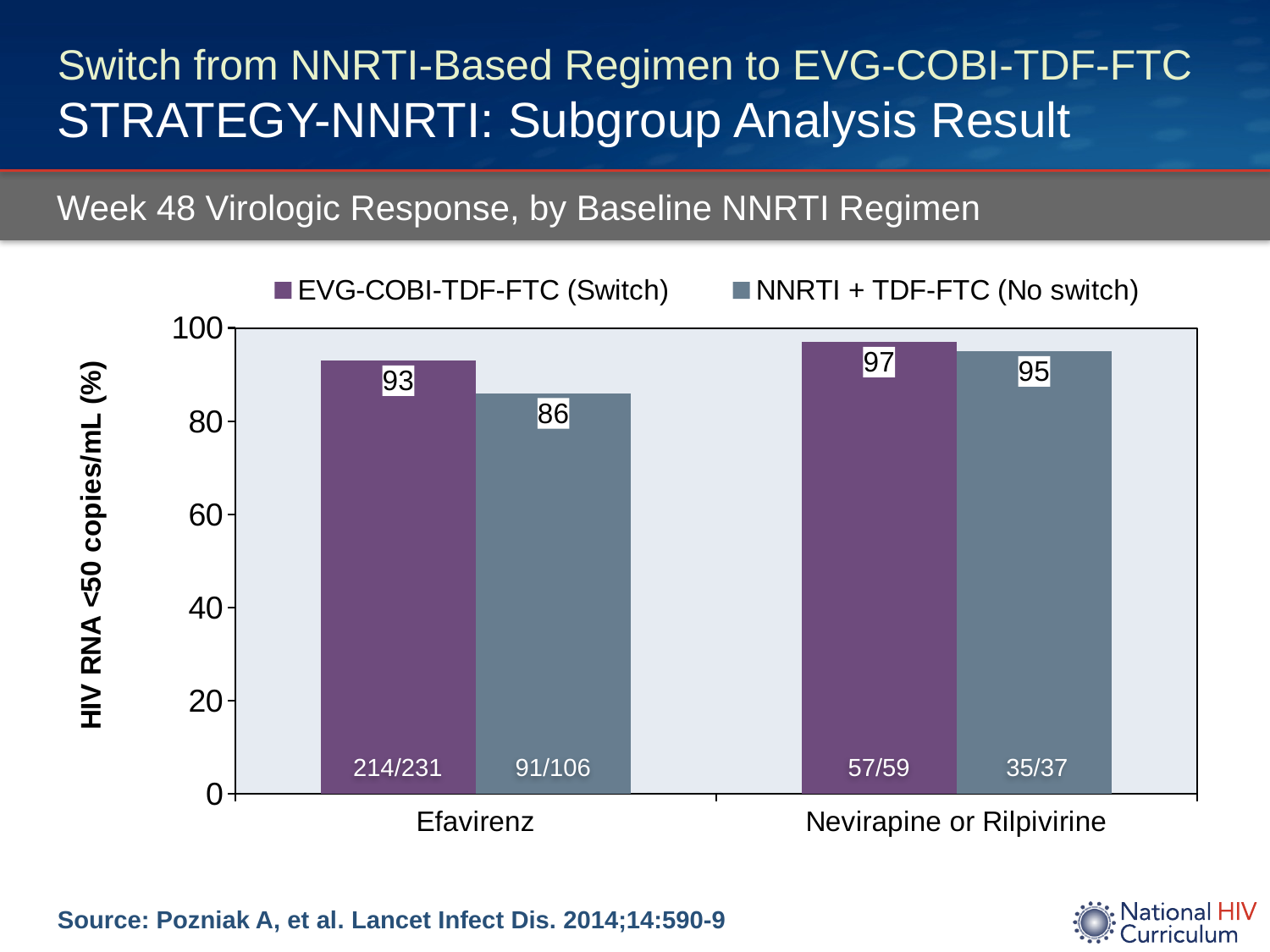
What is the value for EVG-COBI-TDF-FTC (Switch) in the Nevirapine or Rilpivirine group? 97 What is the value for NNRTI + TDF-FTC (No switch) in the Efavirenz group? 86 What is the value for NNRTI + TDF-FTC (No switch) in the Nevirapine or Rilpivirine group? 95 How many series does the legend list? 2 What is the difference between the Switch and No switch values in the Efavirenz group? 7 Which is larger in the Efavirenz group: the Switch value or the No switch value? EVG-COBI-TDF-FTC (Switch) Which bar has the highest value on the chart? EVG-COBI-TDF-FTC (Switch), Nevirapine or Rilpivirine What fraction is printed inside the EVG-COBI-TDF-FTC (Switch) bar for the Efavirenz group? 214/231 What kind of chart is shown on the slide? Bar chart What is the value for EVG-COBI-TDF-FTC (Switch) in the Efavirenz group? 93 How many baseline NNRTI regimen categories are shown on the x axis? 2 Which bar has the lowest value on the chart? NNRTI + TDF-FTC (No switch), Efavirenz